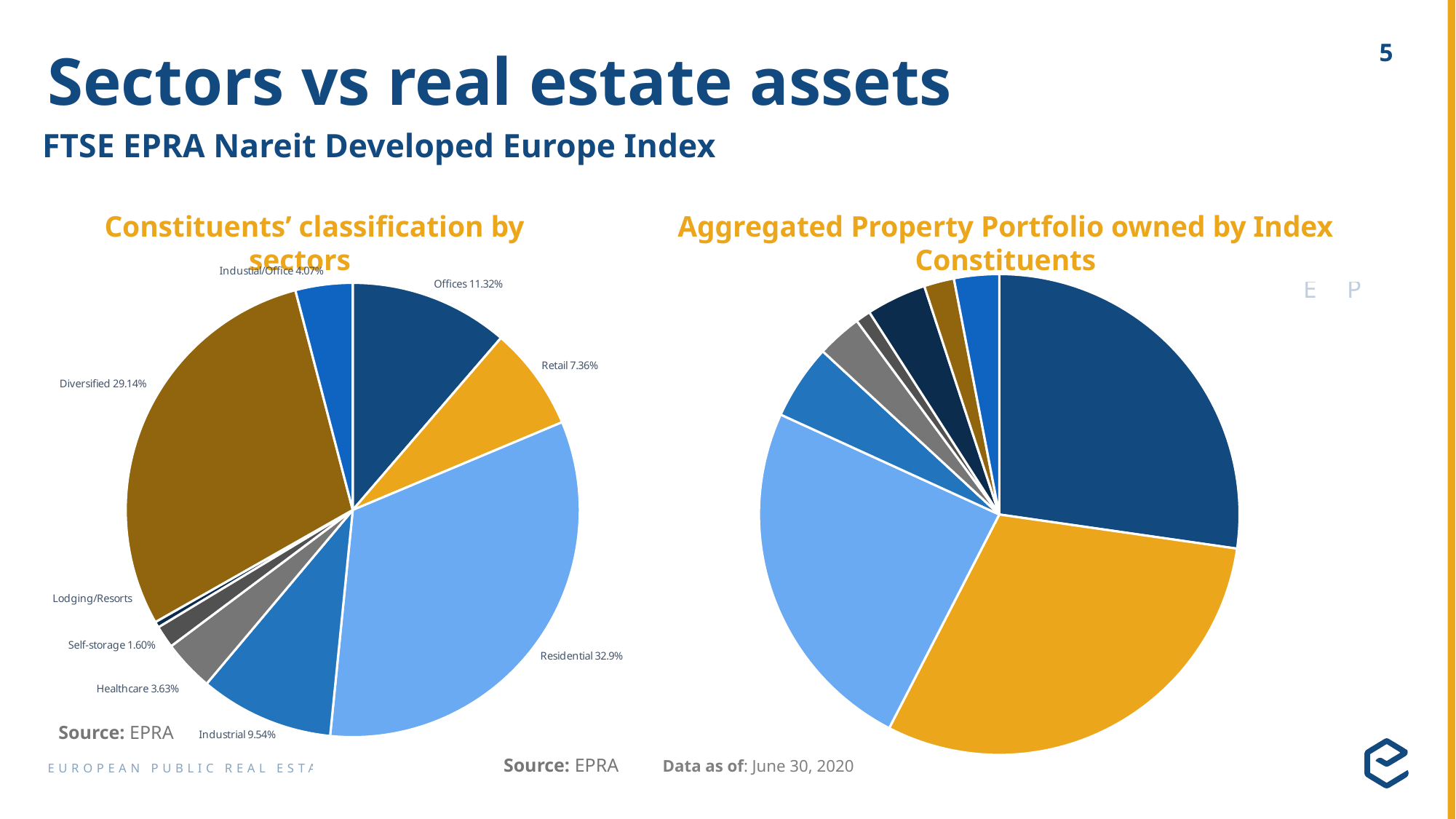
In the 'Constituents' classification by sectors' chart, what is the value for Diversified? 29.14% In the 'Constituents' classification by sectors' chart, which sector has the smallest slice? Lodging/Resorts In the 'Constituents' classification by sectors' chart, which sector has the largest share? Residential How many sectors are shown in the 'Constituents' classification by sectors' chart? 9 In the 'Constituents' classification by sectors' chart, how many percentage points larger is Residential than Diversified? 3.76 In the 'Constituents' classification by sectors' chart, what is the value for Healthcare? 3.63% In the 'Constituents' classification by sectors' chart, what is the value for Industrial/Office? 4.07% What type of chart is the 'Aggregated Property Portfolio owned by Index Constituents' chart? Pie chart What is the source cited for the 'Aggregated Property Portfolio owned by Index Constituents' chart? EPRA In the 'Constituents' classification by sectors' chart, what share does Residential have? 32.9% In the 'Constituents' classification by sectors' chart, which is larger, Offices or Industrial? Offices In the 'Constituents' classification by sectors' chart, what is the difference between Offices and Retail in percentage points? 3.96